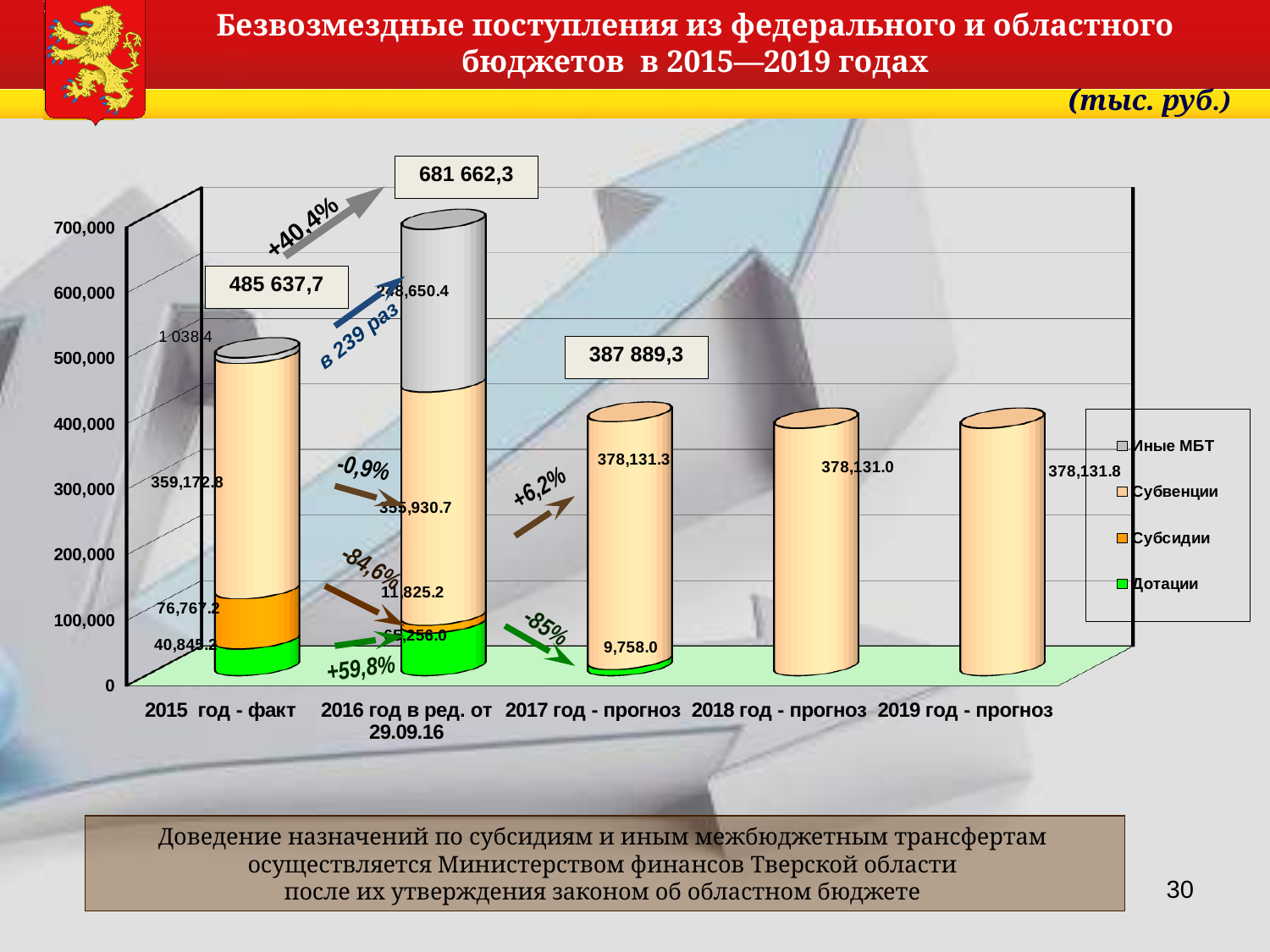
What is the value of Дотации for 2017 год - прогноз? 9,758.0 How many series does the legend list? 4 What is the total value shown above the bar for 2017 год - прогноз? 387 889,3 Is the total value of the bar for 2018 год - прогноз greater or less than 400,000? less What is the total value shown above the bar for 2015 год - факт? 485 637,7 What is the value of Субвенции for 2019 год - прогноз? 378,131.8 What is the value of Субвенции for 2018 год - прогноз? 378,131.0 What kind of chart is shown on the slide? stacked bar chart How many years (categories) are shown on the x axis? 5 What is the difference between the totals for 2016 and 2015? 196 024,6 What is the total value shown above the bar for 2016 год в ред. от 29.09.16? 681 662,3 Which year has the highest total of безвозмездные поступления? 2016 год в ред. от 29.09.16